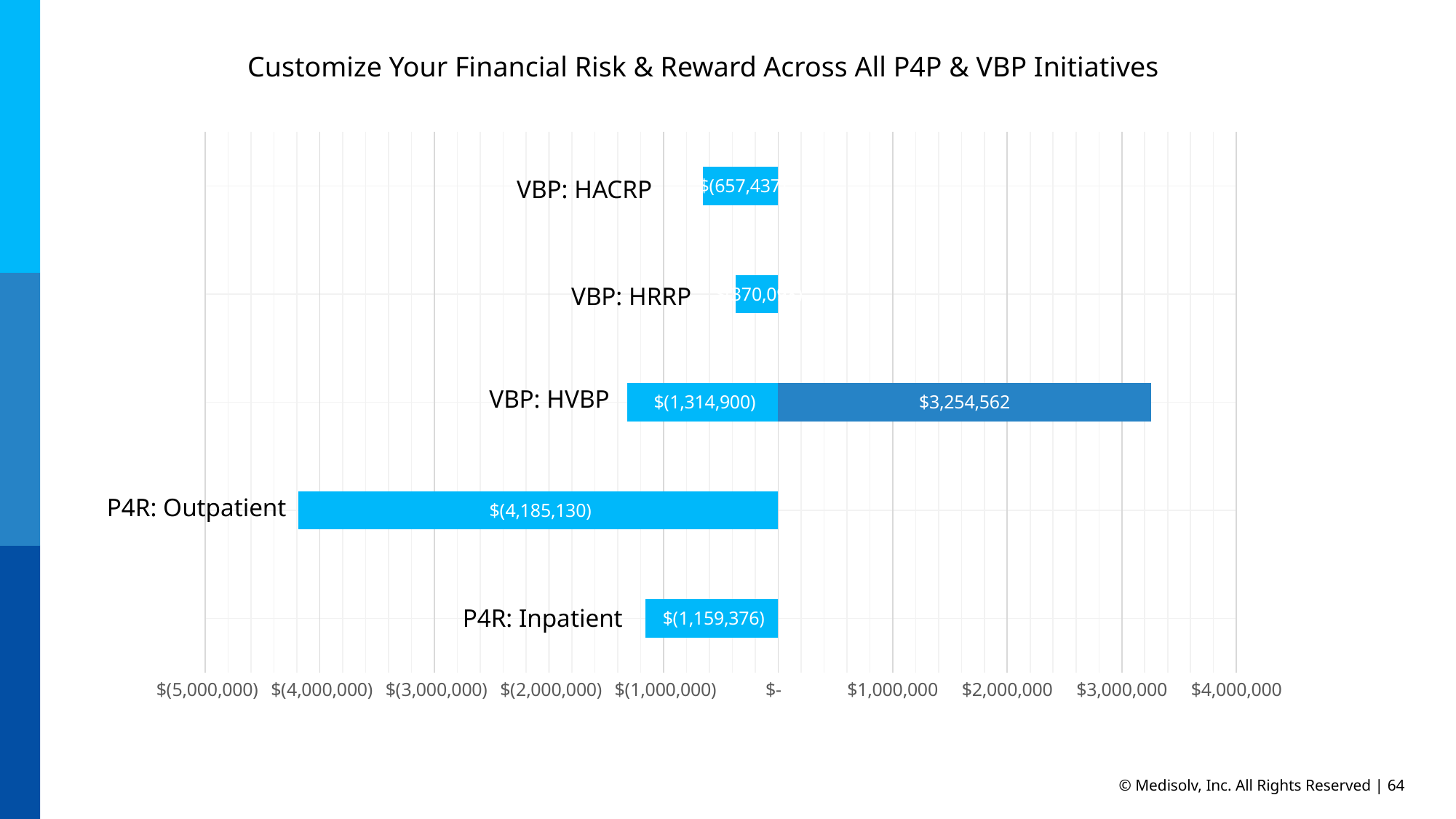
How many categories are plotted on the chart? 5 Which category has the largest negative value (the bar extending furthest to the left)? P4R: Outpatient What is the value shown for P4R: Outpatient? $(4,185,130) What is the difference in magnitude between the P4R: Outpatient value and the P4R: Inpatient value? $3,025,754 What kind of chart is shown on the slide? bar chart Is the magnitude of the VBP: HRRP bar greater or less than $1,000,000? less Which category is the only one with a positive value? VBP: HVBP What is the value shown for VBP: HACRP? $(657,437) What is the negative (light blue) value shown for VBP: HVBP? $(1,314,900) What is the value shown for P4R: Inpatient? $(1,159,376) Which negative value is larger in magnitude: P4R: Inpatient or the negative value for VBP: HVBP? VBP: HVBP What is the positive (dark blue) value shown for VBP: HVBP? $3,254,562